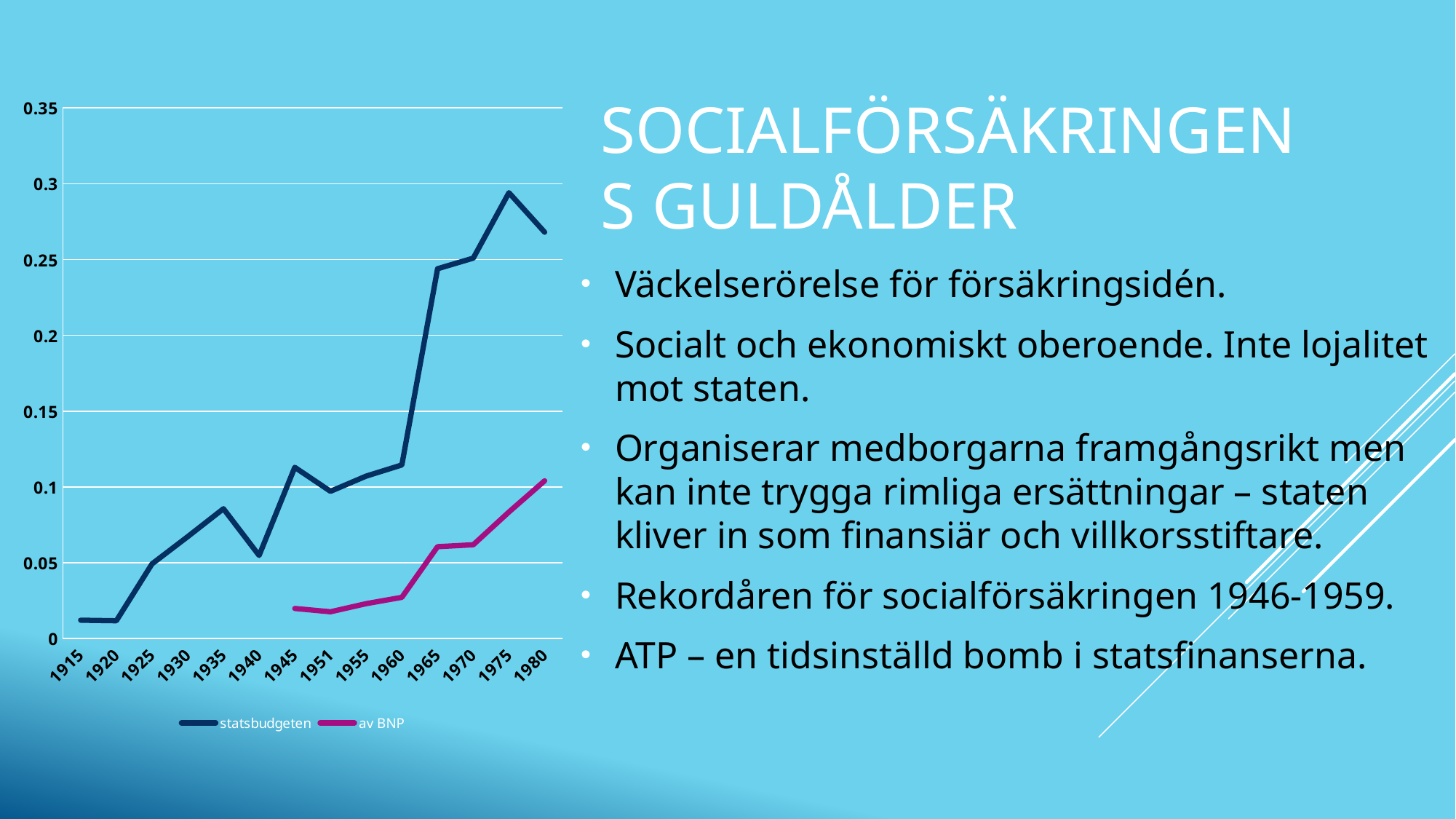
Is the value of statsbudgeten in 1915 greater or less than 0.05? less How many years are marked on the x axis of the chart? 14 Is the value of statsbudgeten in 1965 greater or less than 0.2? greater What kind of chart is shown on the slide? line chart Which colour is used for the av BNP series line? magenta Is the value of statsbudgeten in 1975 greater or less than 0.25? greater In 1980, which series has the larger value, statsbudgeten or av BNP? statsbudgeten Does the av BNP series rise or fall between 1951 and 1980? rise How many series does the chart legend list? 2 What are the names of the two series in the chart legend? statsbudgeten and av BNP In which year does the statsbudgeten series reach its highest value? 1975